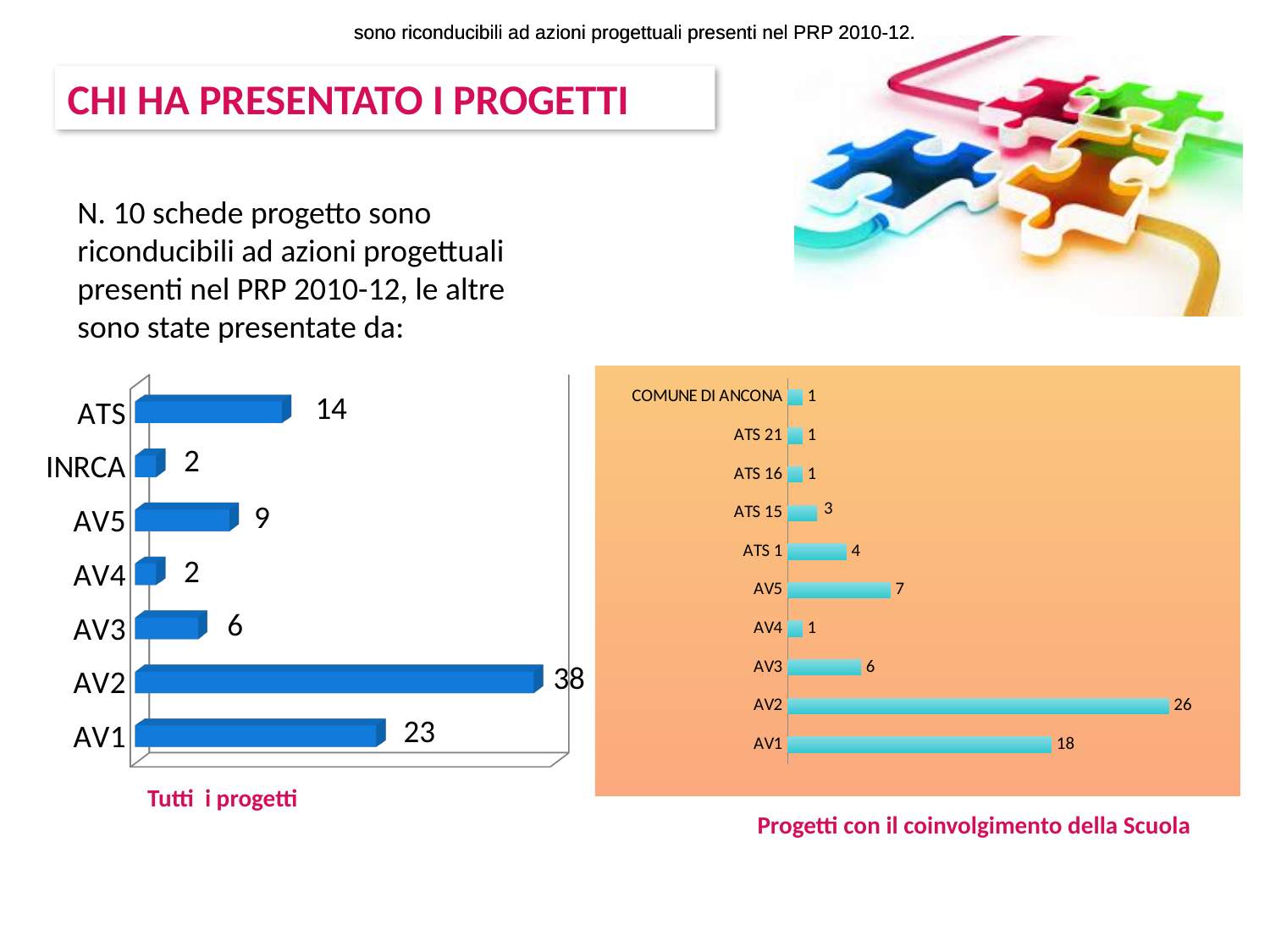
In the left chart (Tutti i progetti), which is larger, AV5 or AV3? AV5 In the left chart (Tutti i progetti), what is the value for AV2? 38 In the left chart (Tutti i progetti), which category has the highest value? AV2 In the left chart (Tutti i progetti), how many categories are shown? 7 In the right chart (Progetti con il coinvolgimento della Scuola), how many categories are shown? 10 What kind of chart is the left chart (Tutti i progetti)? Bar chart In the right chart (Progetti con il coinvolgimento della Scuola), what is the value for ATS 1? 4 In the left chart (Tutti i progetti), what is the value for ATS? 14 In the right chart (Progetti con il coinvolgimento della Scuola), what is the difference between AV2 and AV5? 19 In the left chart (Tutti i progetti), what is the difference between AV2 and AV1? 15 In the right chart (Progetti con il coinvolgimento della Scuola), which category has the highest value? AV2 In the right chart (Progetti con il coinvolgimento della Scuola), what is the value for AV1? 18